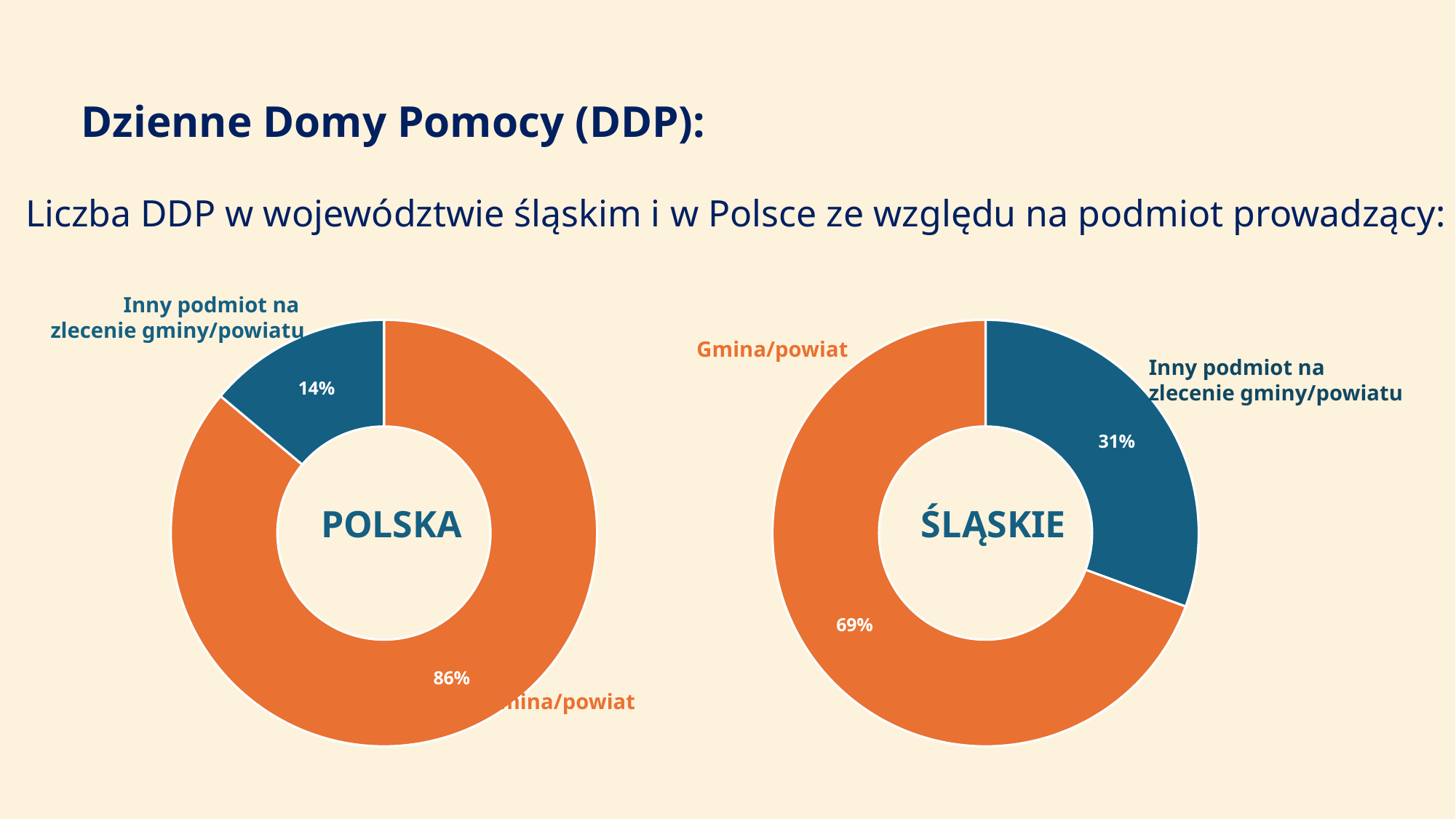
What colour represents Gmina/powiat in both charts? Orange What is the difference in percentage points between the Gmina/powiat share in the POLSKA chart and in the ŚLĄSKIE chart? 17 How many categories does the ŚLĄSKIE chart show? 2 In the POLSKA chart, what share of DDP is run by Inny podmiot na zlecenie gminy/powiatu? 14% In the POLSKA chart, what is the difference in percentage points between the Gmina/powiat share and the Inny podmiot share? 72 What type of chart is used for POLSKA and ŚLĄSKIE? Pie (doughnut) chart In the ŚLĄSKIE chart, which category has the smallest share? Inny podmiot na zlecenie gminy/powiatu In the ŚLĄSKIE chart, what share of DDP is run by Inny podmiot na zlecenie gminy/powiatu? 31% In the POLSKA chart, which category has the largest share? Gmina/powiat Which chart shows a larger share for Inny podmiot na zlecenie gminy/powiatu, POLSKA or ŚLĄSKIE? ŚLĄSKIE In the POLSKA chart, what share of DDP is run by Gmina/powiat? 86% In the ŚLĄSKIE chart, what share of DDP is run by Gmina/powiat? 69%